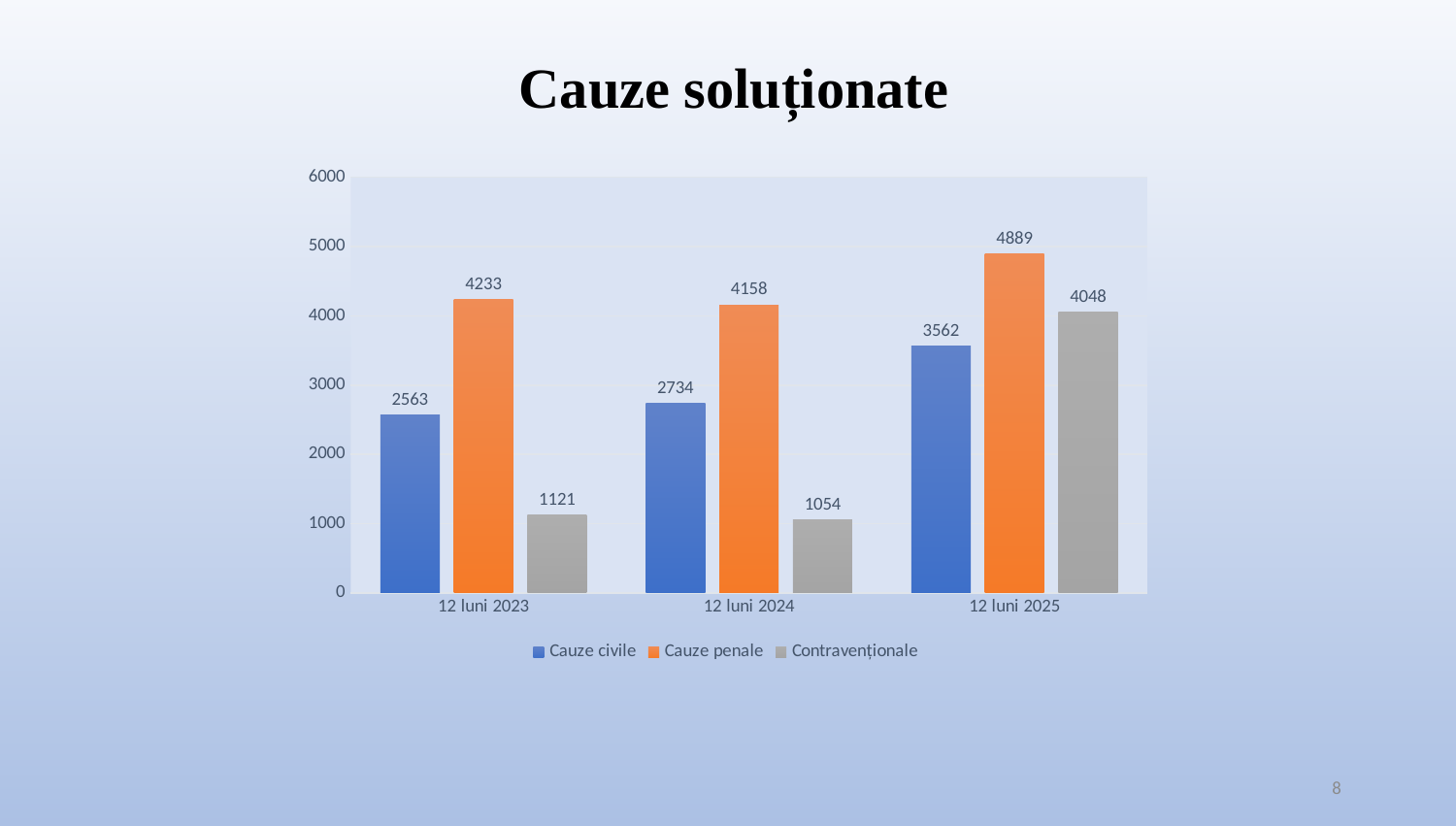
How many periods are shown on the x axis? 3 What is the value for Cauze civile in 12 luni 2023? 2563 In which period is the value for Cauze penale highest? 12 luni 2025 What is the value for Contravenționale in 12 luni 2024? 1054 What is the title of the chart? Cauze soluționate Which is larger in 12 luni 2025: Cauze civile or Contravenționale? Contravenționale Do the values for Cauze civile rise or fall from 12 luni 2023 to 12 luni 2025? Rise In which period is the value for Contravenționale lowest? 12 luni 2024 How many series does the legend list? 3 What kind of chart is shown on the slide? Bar chart What is the value for Cauze penale in 12 luni 2025? 4889 What is the difference between Cauze penale and Cauze civile in 12 luni 2024? 1424